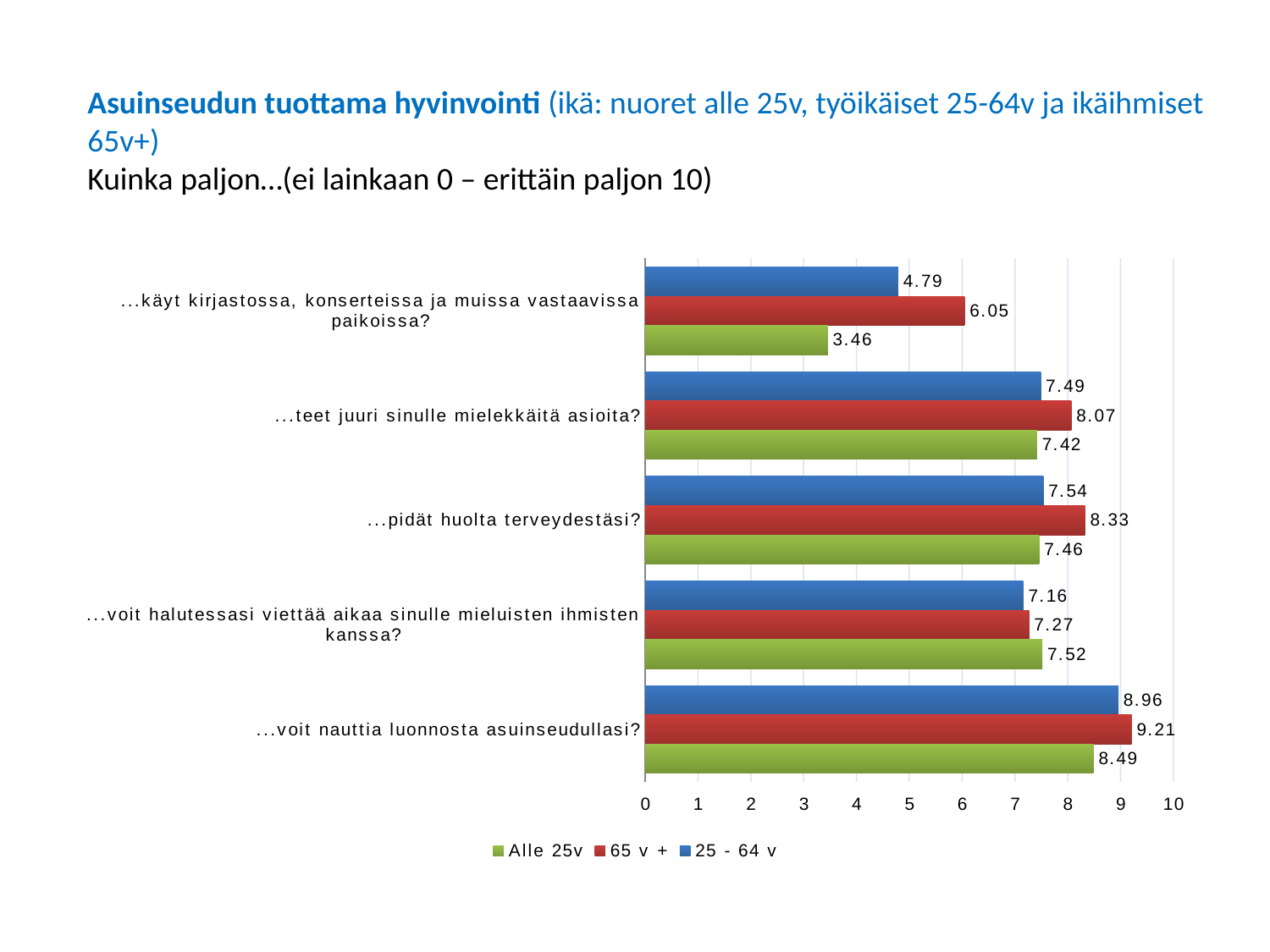
How many categories (questions) are shown on the chart? 5 Is the value for the 25 - 64 v series for "...voit nauttia luonnosta asuinseudullasi?" greater or less than 8? greater What is the difference between the 65 v + and Alle 25v values for "...käyt kirjastossa, konserteissa ja muissa vastaavissa paikoissa?"? 2.59 What is the value for the 25 - 64 v series for "...pidät huolta terveydestäsi?"? 7.54 For "...voit halutessasi viettää aikaa sinulle mieluisten ihmisten kanssa?", which series has the larger value: Alle 25v or 25 - 64 v? Alle 25v Which category has the lowest value for the 25 - 64 v series? ...käyt kirjastossa, konserteissa ja muissa vastaavissa paikoissa? What kind of chart is shown on the slide? Bar chart What is the value for the Alle 25v series for "...käyt kirjastossa, konserteissa ja muissa vastaavissa paikoissa?"? 3.46 Which category has the highest value for the Alle 25v series? ...voit nauttia luonnosta asuinseudullasi? What is the value for the 65 v + series for "...voit nauttia luonnosta asuinseudullasi?"? 9.21 How many series does the legend list? 3 What is the value for the 65 v + series for "...teet juuri sinulle mielekkäitä asioita?"? 8.07